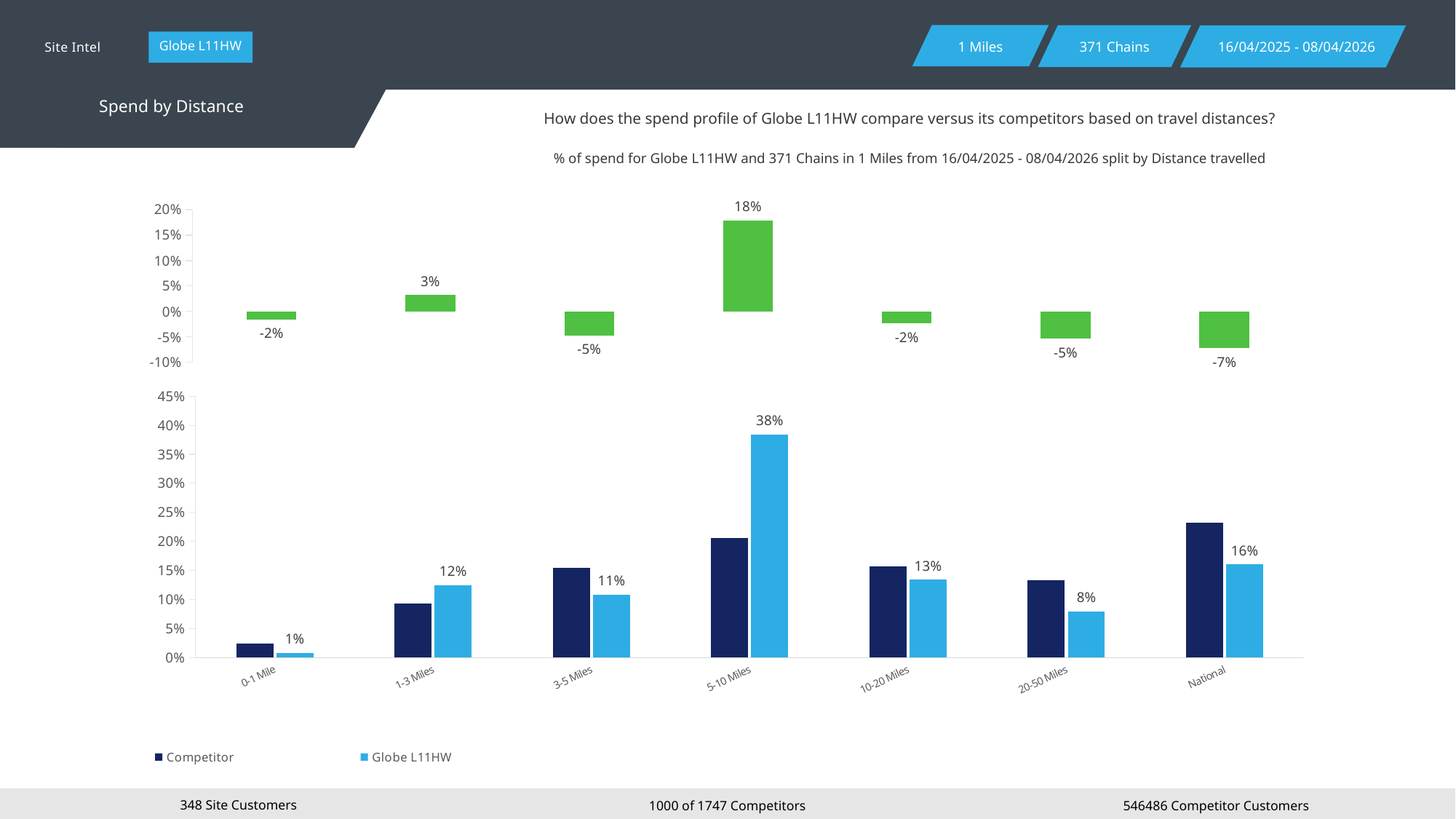
In the bottom chart, what is the difference between the Globe L11HW values for 1-3 Miles and 3-5 Miles? 1% In the bottom chart, is the Competitor value for National greater or less than 20%? greater How many distance categories are shown on the x axis of the bottom chart? 7 In the bottom chart, is the Competitor value for 1-3 Miles greater or less than 10%? less In the bottom chart, which category has the lowest Globe L11HW value? 0-1 Mile In the bottom chart, for the National category, which is larger: the Competitor bar or the Globe L11HW bar? Competitor In the bottom chart, what is the value for Globe L11HW in the National category? 16% In the bottom chart, what is the value for Globe L11HW in the 5-10 Miles category? 38% In the bottom chart, which category has the highest Globe L11HW value? 5-10 Miles In the top green chart, what is the highest value shown? 18% What type of chart is the bottom chart? bar chart How many series does the legend of the bottom chart list? 2